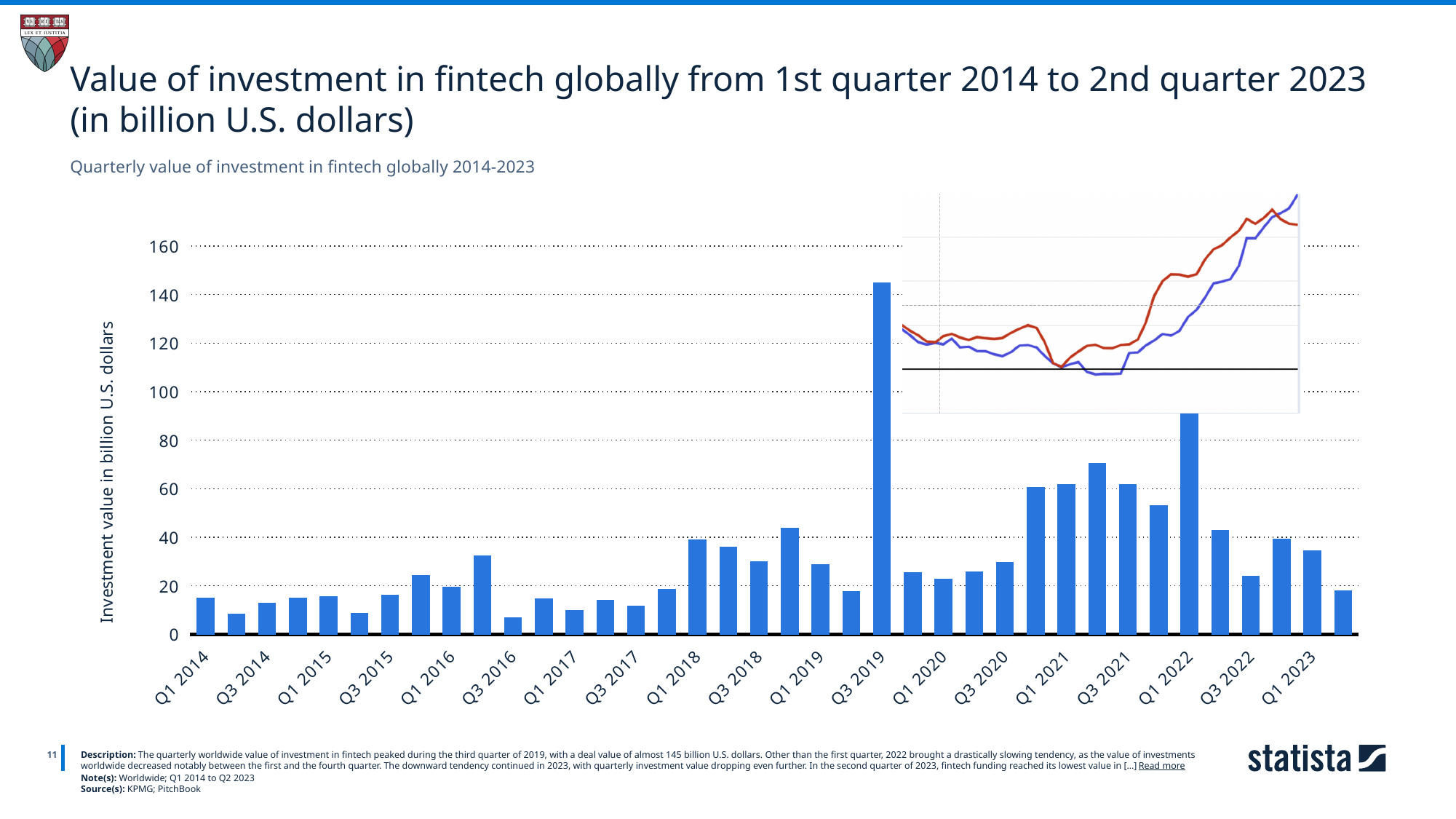
Is the investment value for Q1 2023 greater or less than 40 billion U.S. dollars? less How many quarterly bars are plotted in the chart? 38 Which quarter has the larger investment value, Q1 2017 or Q1 2021? Q1 2021 Is the investment value for Q3 2019 greater or less than 140 billion U.S. dollars? greater Is the investment value for Q1 2022 greater or less than 80 billion U.S. dollars? greater Which quarter has the highest fintech investment value? Q3 2019 Which quarter has the larger investment value, Q3 2019 or Q1 2022? Q3 2019 What is the label of the vertical axis? Investment value in billion U.S. dollars Does the investment value rise or fall from Q3 2020 to Q1 2021? rise What kind of chart is shown on the slide? Bar chart